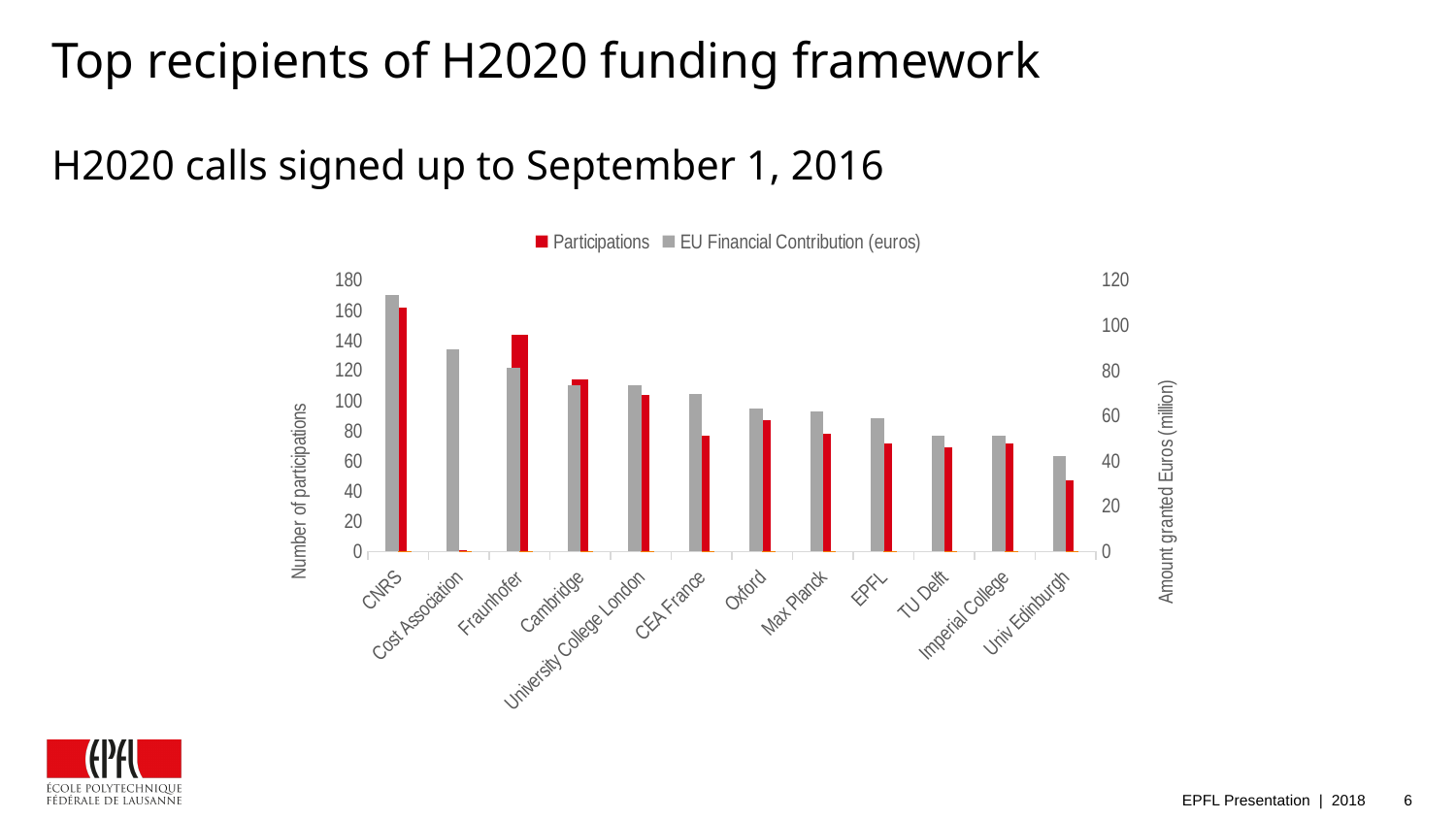
Which institution has the highest number of Participations? CNRS Do the EU Financial Contribution values generally rise or fall from left to right along the x axis? fall Which has more Participations, Cambridge or CEA France? Cambridge How many series does the chart legend list? 2 How many institutions are shown along the x axis of the chart? 12 What colour are the Participations bars in the chart? red Which institution has the highest EU Financial Contribution? CNRS Is the number of Participations for CNRS greater or less than 140? greater What kind of chart is shown on the slide? bar chart Which institution has the lowest EU Financial Contribution? Univ Edinburgh Which institution has the lowest number of Participations? Cost Association Is the number of Participations for Univ Edinburgh greater or less than 60? less